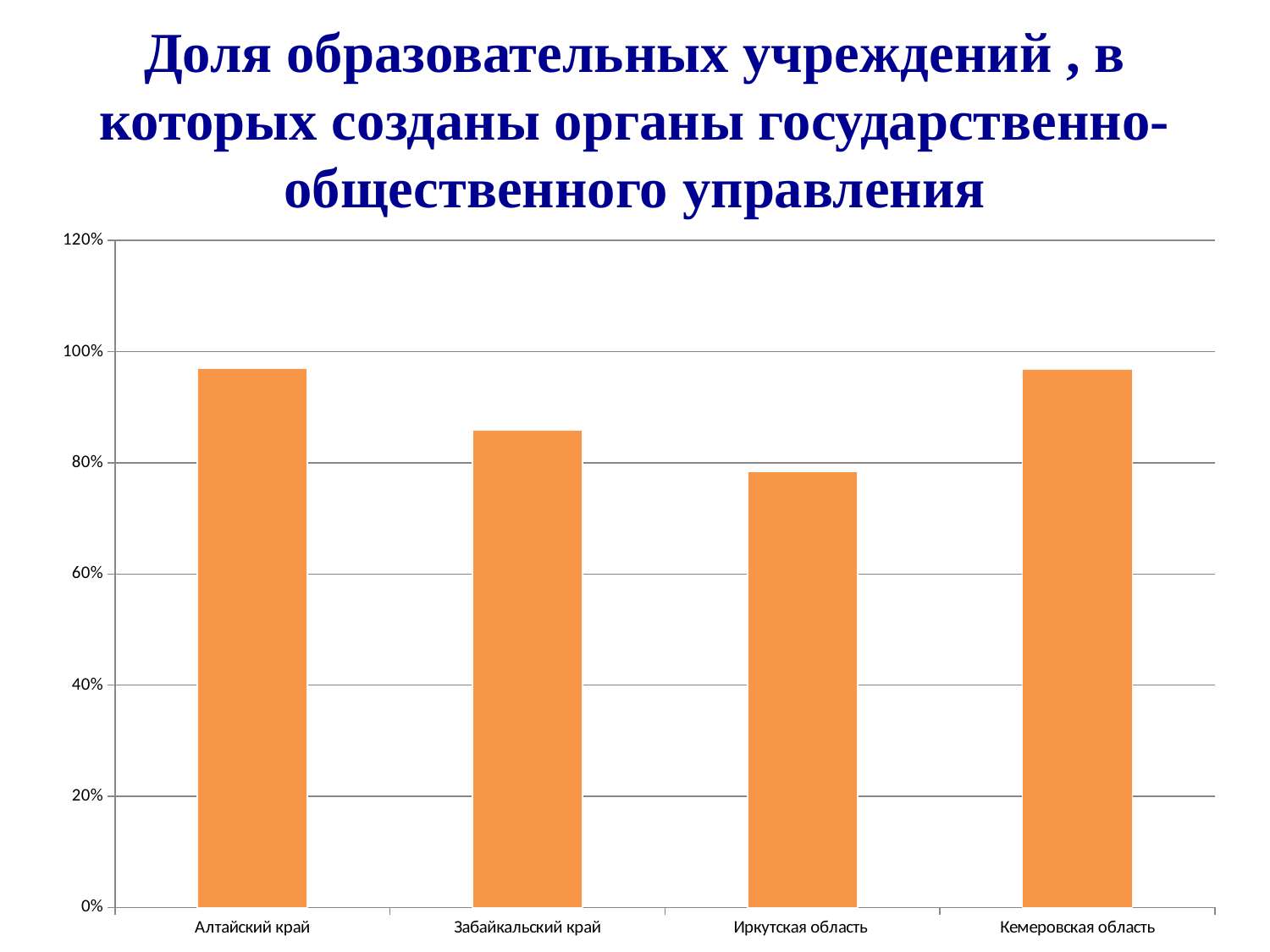
What kind of chart is shown on the slide? bar chart Is the value for Забайкальский край greater or less than 80%? greater Which region has the lowest value on the chart? Иркутская область What is the highest value shown on the vertical axis? 120% Is the value for Алтайский край greater or less than 80%? greater Is the value for Иркутская область greater or less than 60%? greater Which is larger, the value for Кемеровская область or the value for Забайкальский край? Кемеровская область Which is larger, the value for Забайкальский край or the value for Иркутская область? Забайкальский край What colour are the bars on the chart? orange How many regions (categories) are shown on the chart? 4